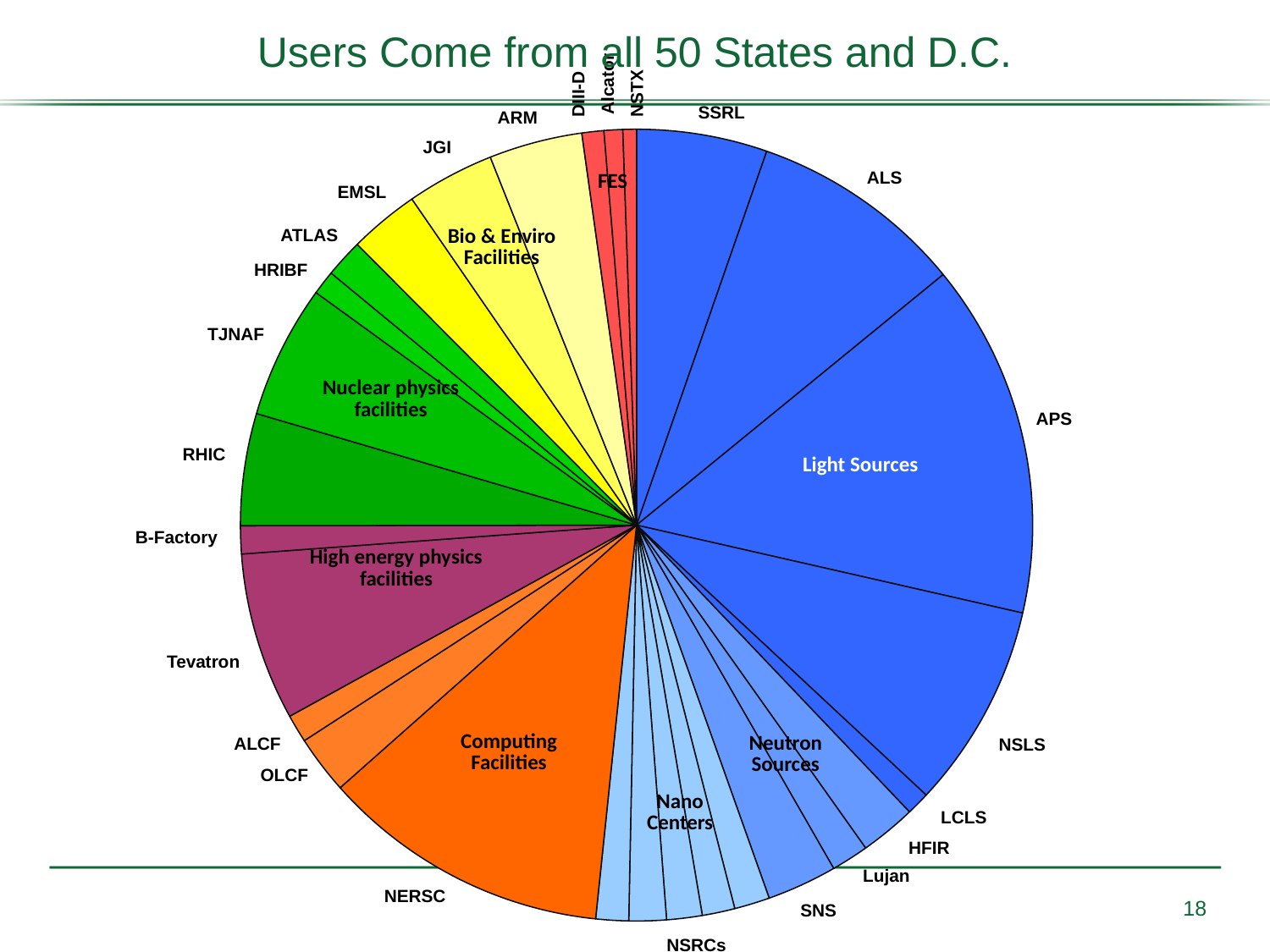
Which facility group occupies the largest portion of the pie? Light Sources What kind of chart is shown on the slide? pie chart Which slice is larger, Tevatron or B-Factory? Tevatron Which slice is larger, ALS or LCLS? ALS What is the title of the slide containing the pie chart? Users Come from all 50 States and D.C. Which slice is larger, NERSC or ALCF? NERSC Which facility has the largest slice of the pie? APS What colour are the Computing Facilities slices in the pie chart? orange